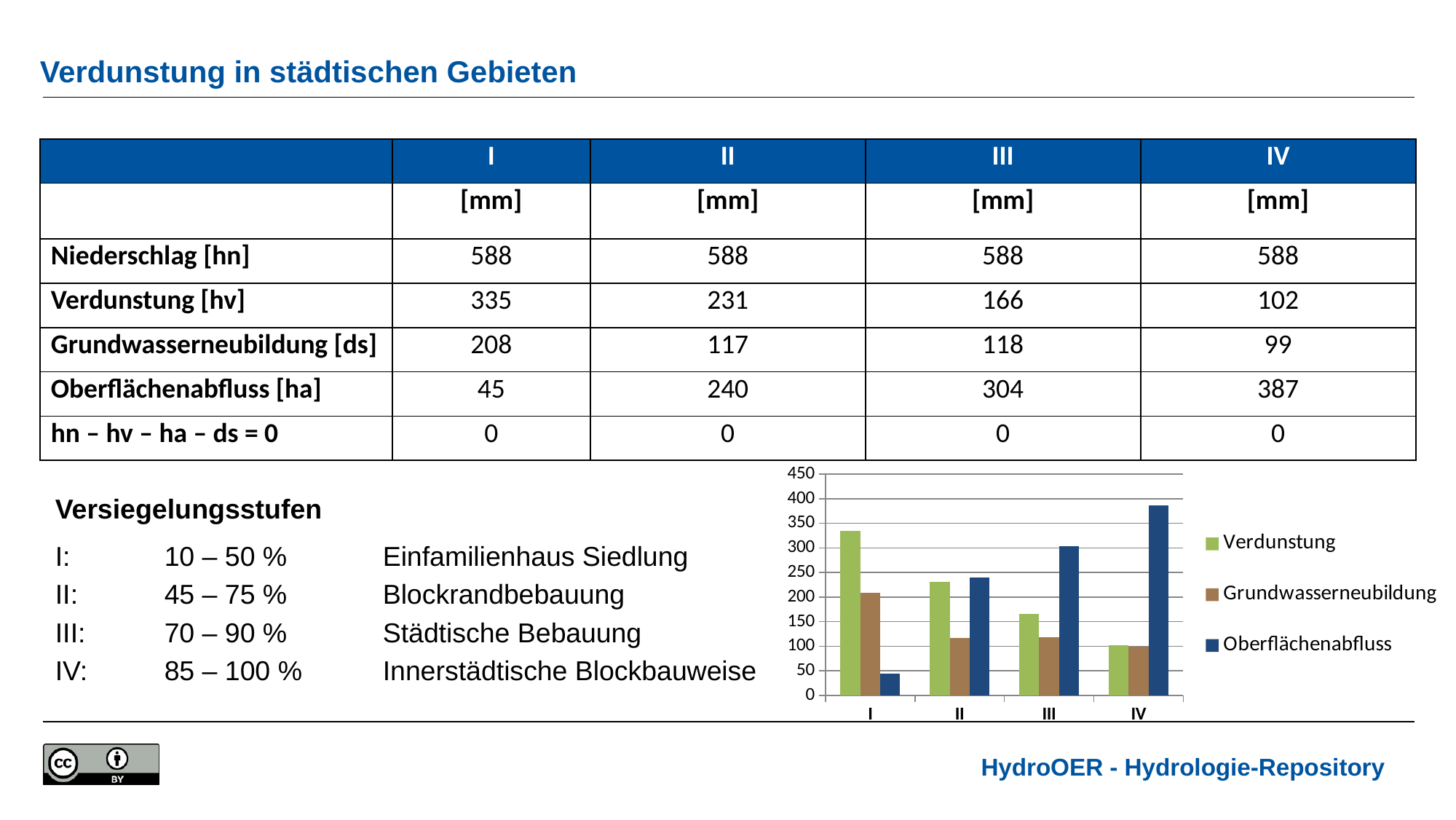
How many categories are shown on the x axis of the chart? 4 Which category has the lowest Verdunstung bar in the chart? IV Does the Oberflächenabfluss series rise or fall from category I to category IV? rise What kind of chart is shown on the slide? bar chart Which category has the highest Oberflächenabfluss bar in the chart? IV How many series does the chart legend list? 3 Is the Verdunstung value for category I greater or less than 300? greater What is the Oberflächenabfluss value for category IV, as printed in the table on the slide? 387 Which colour represents Grundwasserneubildung in the chart? brown Is the Oberflächenabfluss value for category I greater or less than 50? less In category III, which is larger: Verdunstung or Oberflächenabfluss? Oberflächenabfluss Does the Verdunstung series rise or fall from category I to category IV? fall